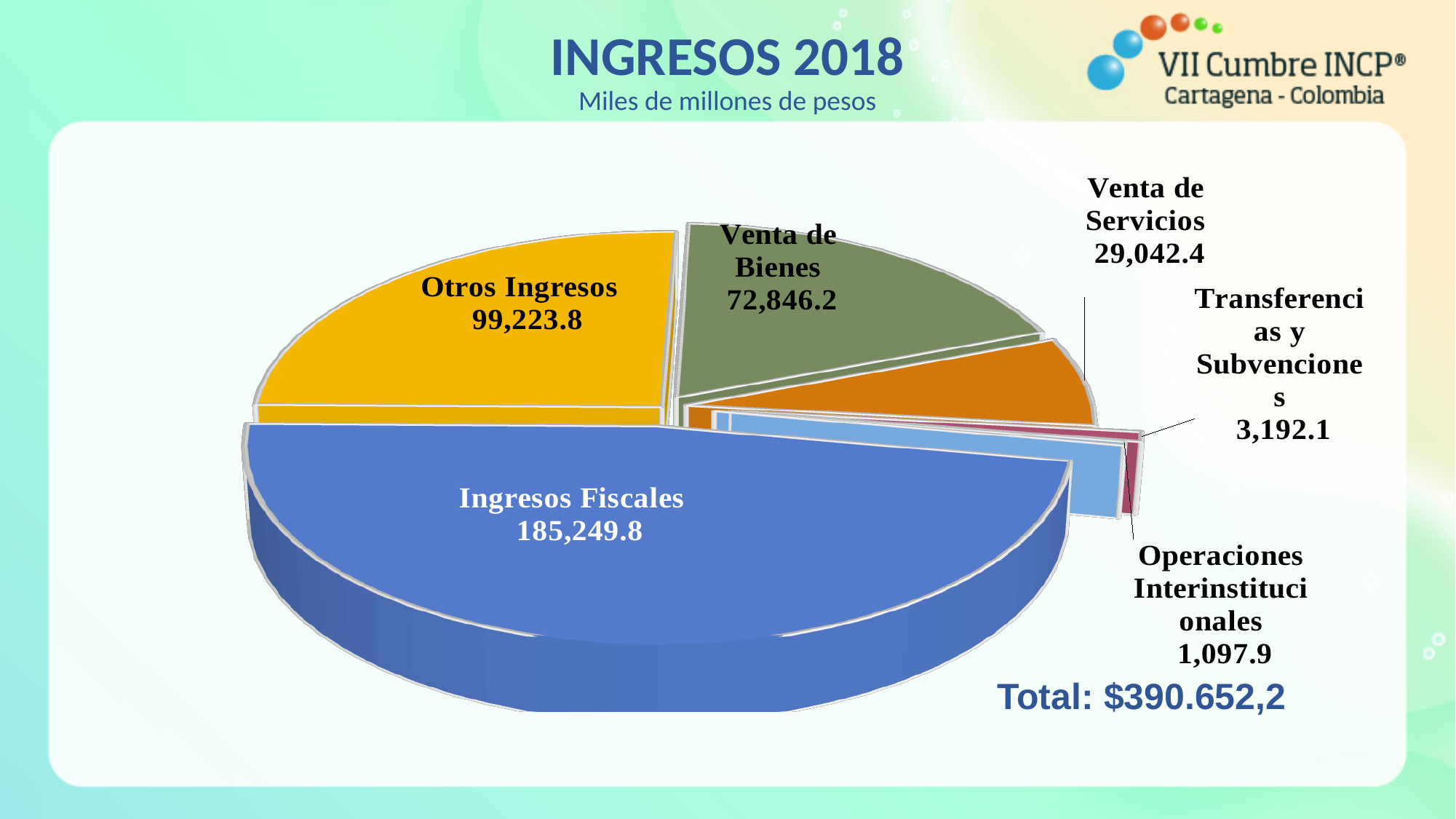
What is the value for Ingresos Fiscales? 185,249.8 What is the value for Transferencias y Subvenciones? 3,192.1 Which category has the largest slice of the pie? Ingresos Fiscales What is the value for Venta de Servicios? 29,042.4 What type of chart is shown on the slide? Pie chart What unit is stated in the subtitle of the chart? Miles de millones de pesos What is the difference between Ingresos Fiscales and Otros Ingresos? 86,026.0 What total is printed on the slide for the chart? $390.652,2 Which category has the smallest slice of the pie? Operaciones Interinstitucionales What is the difference between Venta de Bienes and Venta de Servicios? 43,803.8 Which is larger, Otros Ingresos or Venta de Bienes? Otros Ingresos How many categories are shown in the pie chart? 6